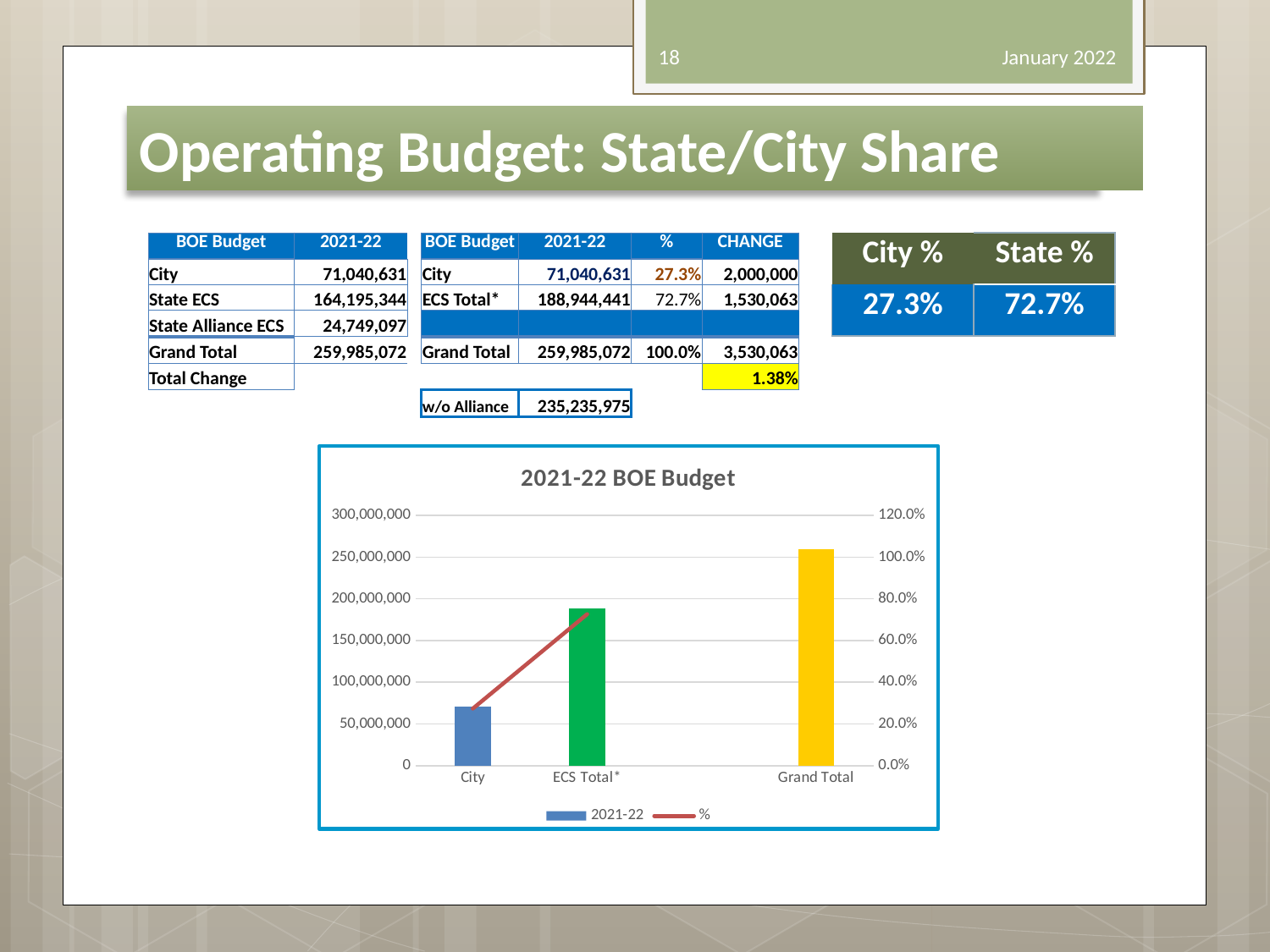
How many categories are shown on the x axis of the 2021-22 BOE Budget chart? 3 How many series does the legend of the 2021-22 BOE Budget chart list? 2 In the 2021-22 BOE Budget chart, is the bar for City greater or less than 100,000,000? less Which category has the tallest bar in the 2021-22 BOE Budget chart? Grand Total In the 2021-22 BOE Budget chart, which bar is taller, City or ECS Total*? ECS Total* What are the two legend entries in the 2021-22 BOE Budget chart? 2021-22 and % What is the title of the chart on the slide? 2021-22 BOE Budget In the 2021-22 BOE Budget chart, is the bar for ECS Total* greater or less than 150,000,000? greater What kind of chart is the 2021-22 BOE Budget chart? combination bar and line chart In the 2021-22 BOE Budget chart, does the % line rise or fall from City to ECS Total*? rise In the 2021-22 BOE Budget chart, is the bar for Grand Total greater or less than 250,000,000? greater Which category has the shortest bar in the 2021-22 BOE Budget chart? City